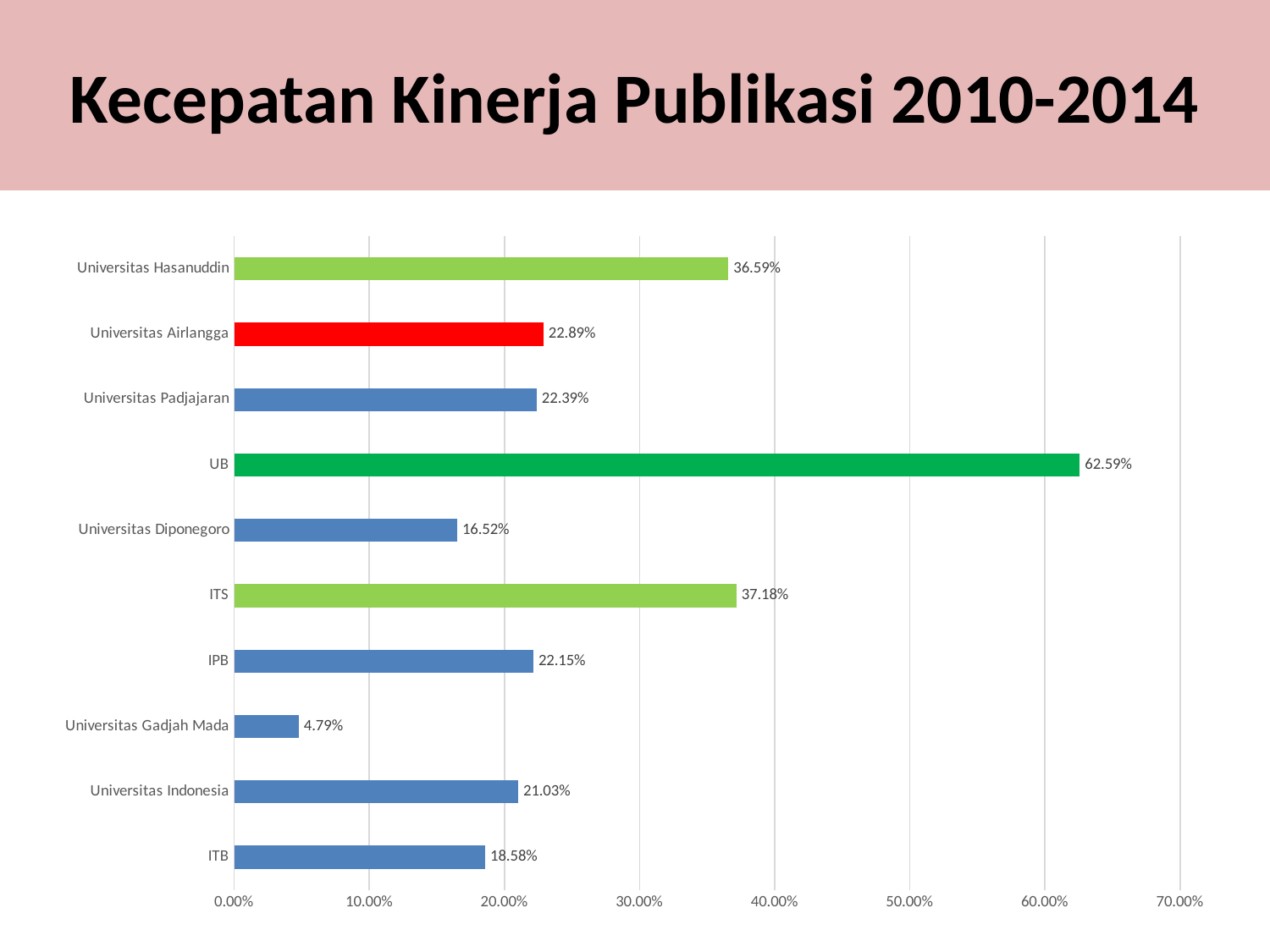
What is the title of the slide? Kecepatan Kinerja Publikasi 2010-2014 Is the value for Universitas Diponegoro greater or less than 20.00%? less Which is larger, the value for Universitas Hasanuddin or the value for Universitas Airlangga? Universitas Hasanuddin What is the value for Universitas Gadjah Mada? 4.79% How many universities are shown in the chart? 10 What is the difference between the values for UB and ITS? 25.41% What is the value for Universitas Indonesia? 21.03% What is the value for ITS? 37.18% Which university has the lowest value? Universitas Gadjah Mada Which university has the highest value? UB What kind of chart is shown on the slide? bar chart What is the value for UB? 62.59%